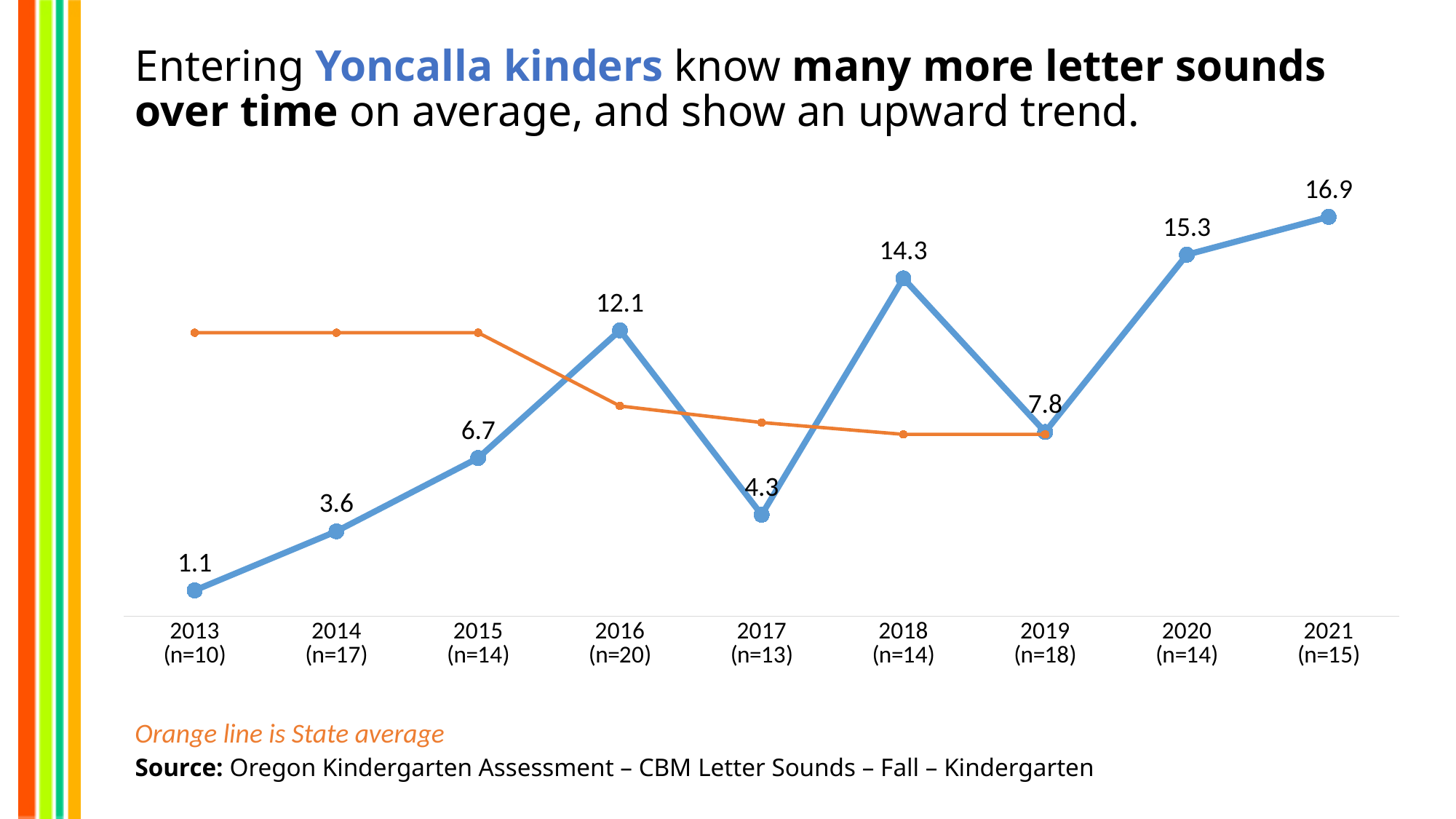
What does the orange line represent? State average Which is larger, the Yoncalla value for 2016 or for 2017? 2016 What is the difference between the Yoncalla values for 2020 and 2019? 7.5 How many years are plotted on the x axis? 9 What is the Yoncalla value for 2015? 6.7 In 2013, which line is higher, the Yoncalla line or the State average line? State average What is the Yoncalla value for 2017? 4.3 What type of chart is shown on the slide? line chart What is the difference between the Yoncalla values for 2021 and 2013? 15.8 Which year has the lowest Yoncalla value? 2013 What is the Yoncalla average letter sounds value for 2021? 16.9 Which year has the highest Yoncalla value? 2021